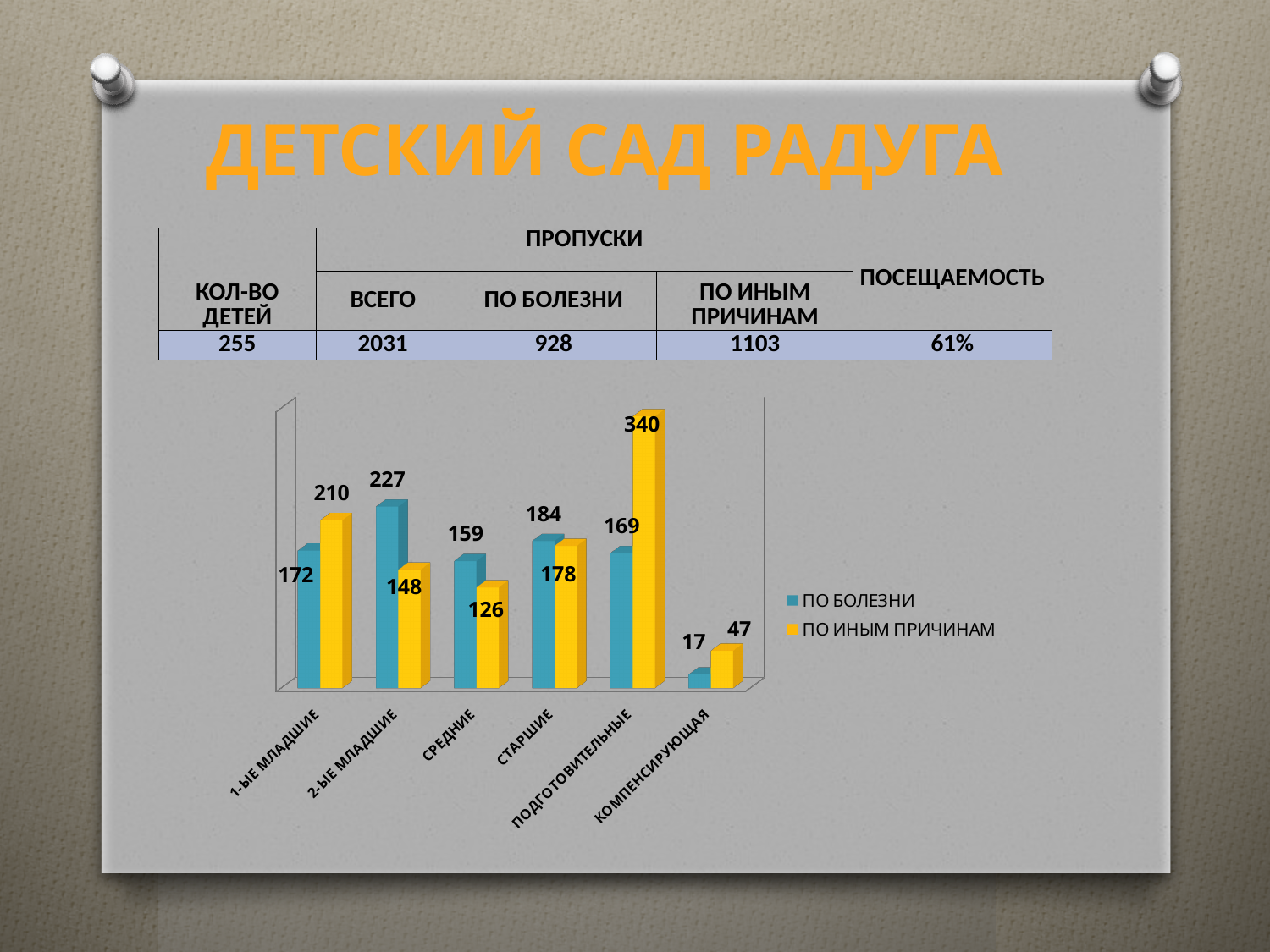
What is the difference between ПО ИНЫМ ПРИЧИНАМ and ПО БОЛЕЗНИ in the ПОДГОТОВИТЕЛЬНЫЕ category? 171 What is the value for ПО БОЛЕЗНИ in the КОМПЕНСИРУЮЩАЯ category? 17 Which category has the lowest value for ПО БОЛЕЗНИ? КОМПЕНСИРУЮЩАЯ What is the value for ПО ИНЫМ ПРИЧИНАМ in the ПОДГОТОВИТЕЛЬНЫЕ category? 340 What is the difference between ПО БОЛЕЗНИ and ПО ИНЫМ ПРИЧИНАМ in the СРЕДНИЕ category? 33 Which series is shown in yellow on the chart? ПО ИНЫМ ПРИЧИНАМ In the 2-ЫЕ МЛАДШИЕ category, which is larger: ПО БОЛЕЗНИ or ПО ИНЫМ ПРИЧИНАМ? ПО БОЛЕЗНИ Which category has the highest value for ПО ИНЫМ ПРИЧИНАМ? ПОДГОТОВИТЕЛЬНЫЕ What kind of chart is shown on the slide? bar chart How many categories are shown on the chart's x axis? 6 What is the value for ПО БОЛЕЗНИ in the 2-ЫЕ МЛАДШИЕ category? 227 How many series does the chart legend list? 2